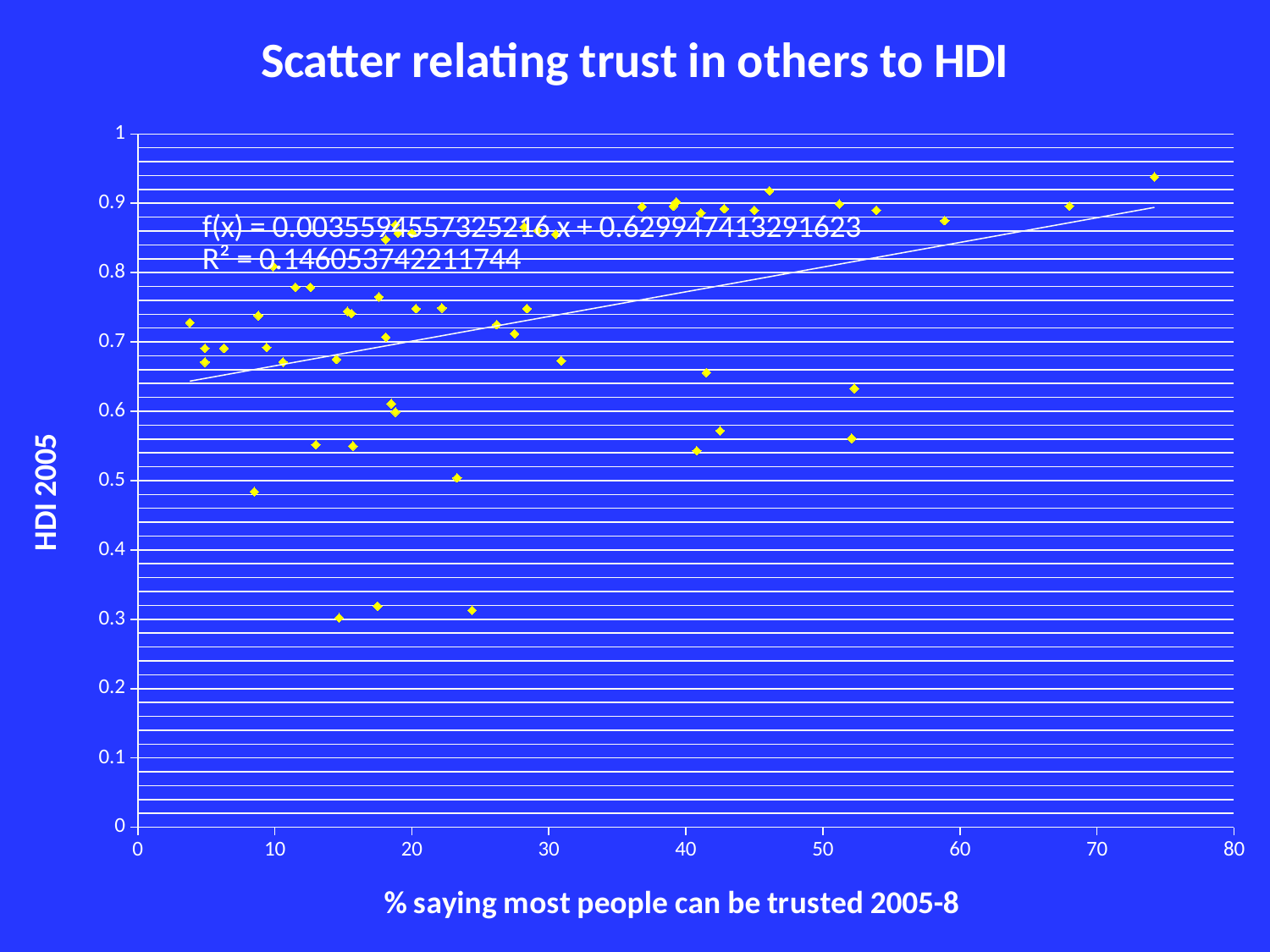
What R² value is printed on the chart? 0.146053742211744 What is the title of the chart? Scatter relating trust in others to HDI What kind of chart is shown on the slide? scatter chart Are any points plotted with an HDI below 0.2? No Is the highest HDI value plotted greater or less than 0.9? greater Does the fitted trendline rise or fall as the percentage saying most people can be trusted increases? rise Is the HDI value of the rightmost point (highest trust percentage) greater or less than 0.9? greater Which has the higher HDI: the rightmost point or the second-rightmost point? the rightmost point